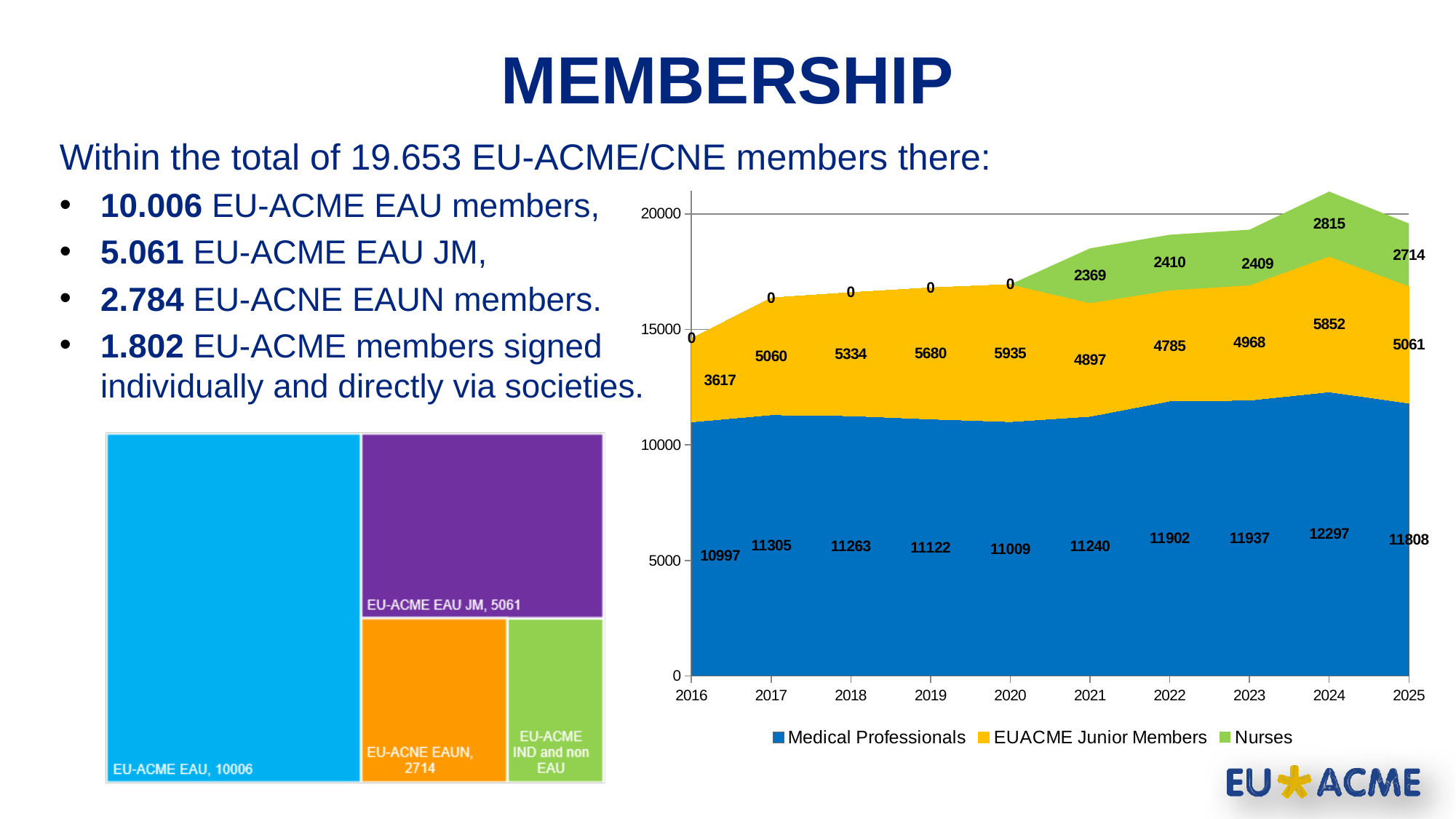
In the stacked area chart on the right, in which year is the EUACME Junior Members value lowest? 2016 What kind of chart is the chart on the right of the slide? Stacked area chart In the stacked area chart on the right, what is the value for EUACME Junior Members in 2016? 3617 In the stacked area chart on the right, what is the difference between the Medical Professionals values in 2024 and 2016? 1300 In the treemap chart on the left, what is the value for EU-ACME EAU JM? 5061 In the stacked area chart on the right, which is larger: the Nurses value in 2024 or in 2025? 2024 In the stacked area chart on the right, what is the value for Nurses in 2021? 2369 In the stacked area chart on the right, what is the value for Medical Professionals in 2024? 12297 In the stacked area chart on the right, how many years are shown on the x axis? 10 In the stacked area chart on the right, how many series does the legend list? 3 In the stacked area chart on the right, in which year is the Medical Professionals value highest? 2024 In the stacked area chart on the right, what is the total of all three series in 2024? 20964